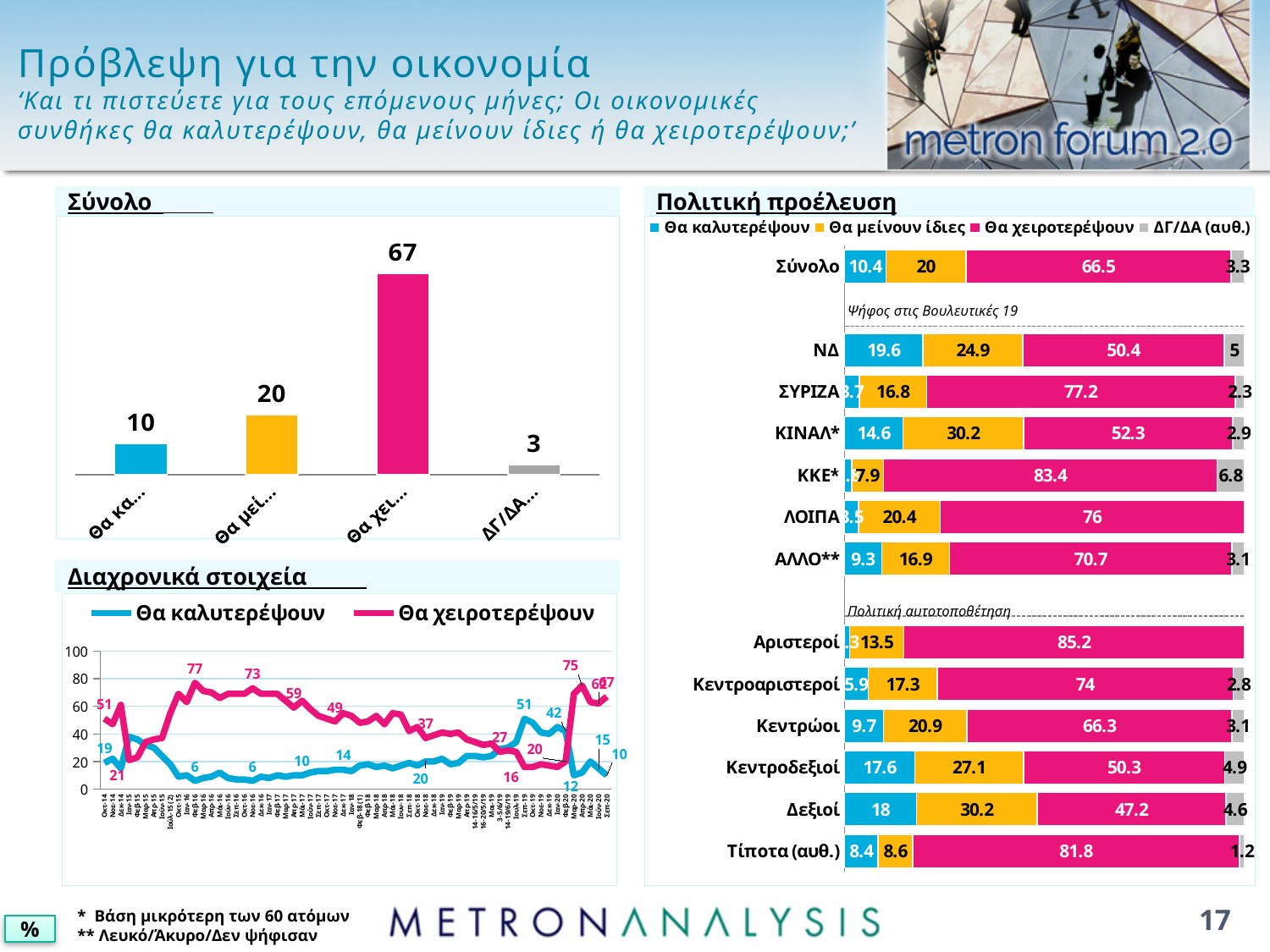
How many series does the legend of the 'Πολιτική προέλευση' chart list? 4 In the 'Σύνολο' bar chart, what is the value of the 'ΔΓ/ΔΑ...' bar? 3 In the 'Σύνολο' bar chart, what is the difference between the 'Θα χει...' bar and the 'Θα μεί...' bar? 47 In the 'Πολιτική προέλευση' chart, what is the 'Θα χειροτερέψουν' value for ΝΔ? 50.4 In the 'Διαχρονικά στοιχεία' chart, what is the highest labelled value of the 'Θα χειροτερέψουν' line? 77 In the 'Πολιτική προέλευση' chart, which has the larger 'Θα χειροτερέψουν' value, ΝΔ or ΣΥΡΙΖΑ? ΣΥΡΙΖΑ How many bars are in the 'Σύνολο' bar chart? 4 How many series does the legend of the 'Διαχρονικά στοιχεία' chart list? 2 In the 'Πολιτική προέλευση' chart, what is the difference between the 'Θα μείνουν ίδιες' values for Δεξιοί and ΝΔ? 5.3 What kind of chart is the 'Διαχρονικά στοιχεία' chart? line chart In the 'Σύνολο' bar chart, what is the value of the tallest bar? 67 In the 'Πολιτική προέλευση' chart, which group has the highest 'Θα χειροτερέψουν' value? Αριστεροί